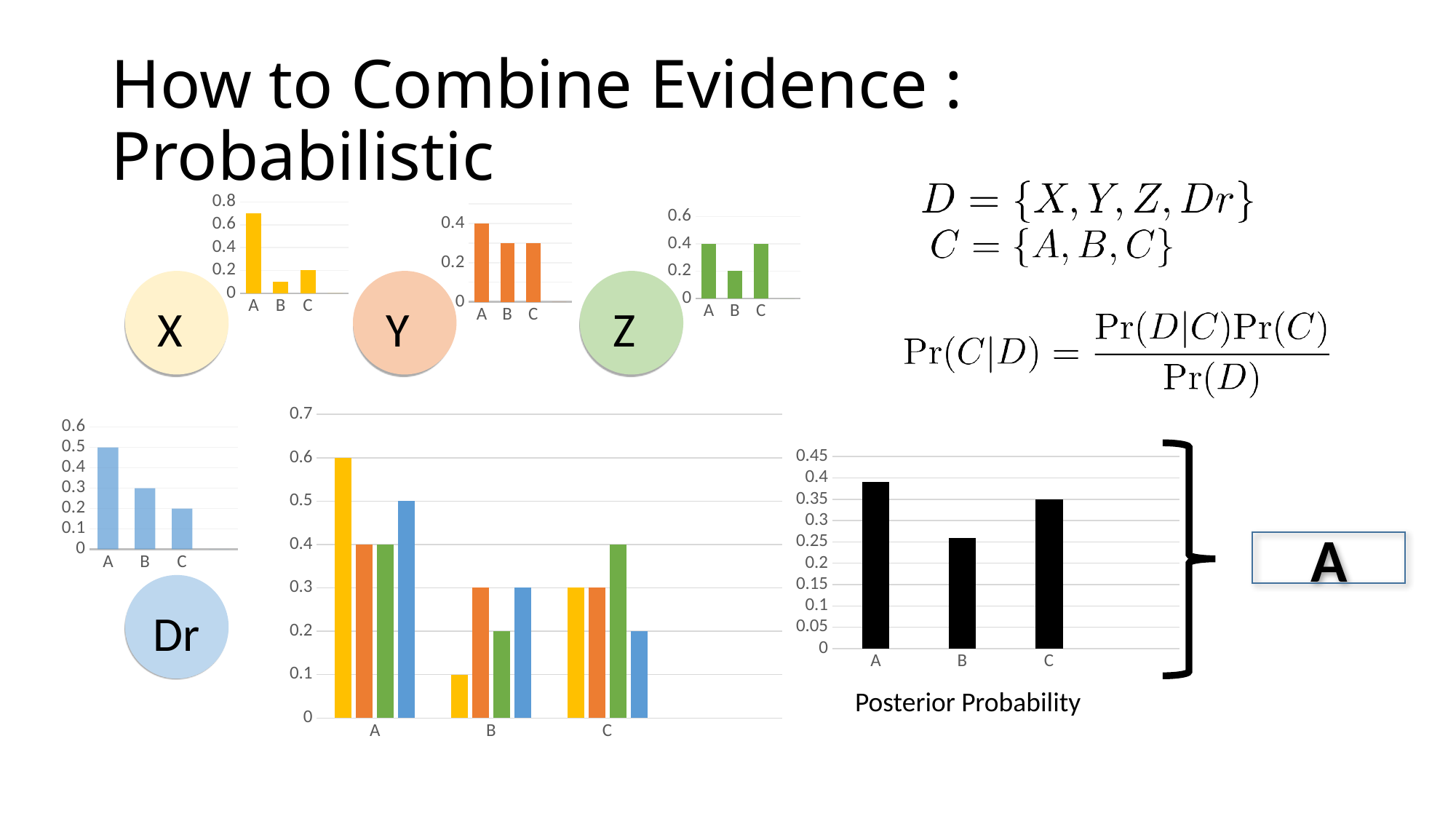
In the Dr chart (blue bars, bottom left), what is the value for A? 0.5 In the Posterior Probability chart, is the value for B greater or less than 0.3? less In the Dr chart (blue bars, bottom left), do the values rise or fall from A to C? fall What kind of chart is the Posterior Probability chart? bar chart In the Posterior Probability chart, which category has the highest value? A In the large grouped bar chart in the middle of the slide, what is the value of the yellow bar for category A? 0.6 How many categories are shown in the Posterior Probability chart? 3 In the X chart (yellow bars), is the value for A greater or less than 0.6? greater In the Y chart (orange bars), what is the value for A? 0.4 In the Posterior Probability chart, which category has the lowest value? B In the Z chart (green bars), what is the value for B? 0.2 In the Dr chart (blue bars, bottom left), what is the difference between the values for A and B? 0.2